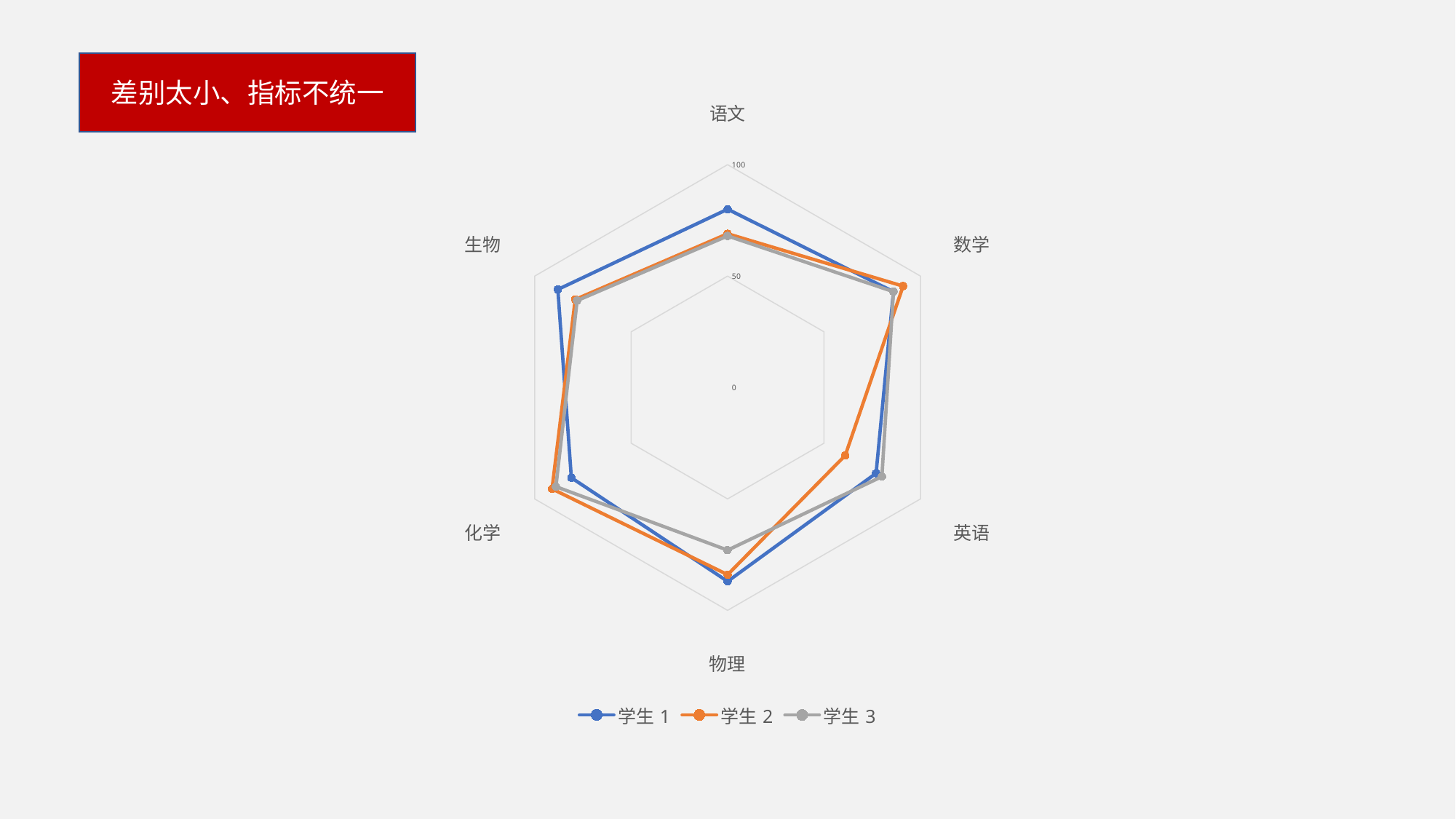
How many series does the legend list? 3 Is the value of 学生 1 for 语文 greater or less than 50? greater What is the maximum value shown on the radar chart's axis? 100 For 学生 2, which subject has the lowest value? 英语 Is the value of 学生 2 for 英语 greater or less than 50? greater How many categories (subjects) does the radar chart have? 6 For 语文, which is higher: 学生 1 or 学生 2? 学生 1 What kind of chart is shown on the slide? radar chart For 化学, which is higher: 学生 1 or 学生 2? 学生 2 Which series are listed in the legend? 学生 1, 学生 2, 学生 3 Is the value of 学生 3 for 物理 greater or less than 50? greater For 英语, which is higher: 学生 1 or 学生 2? 学生 1